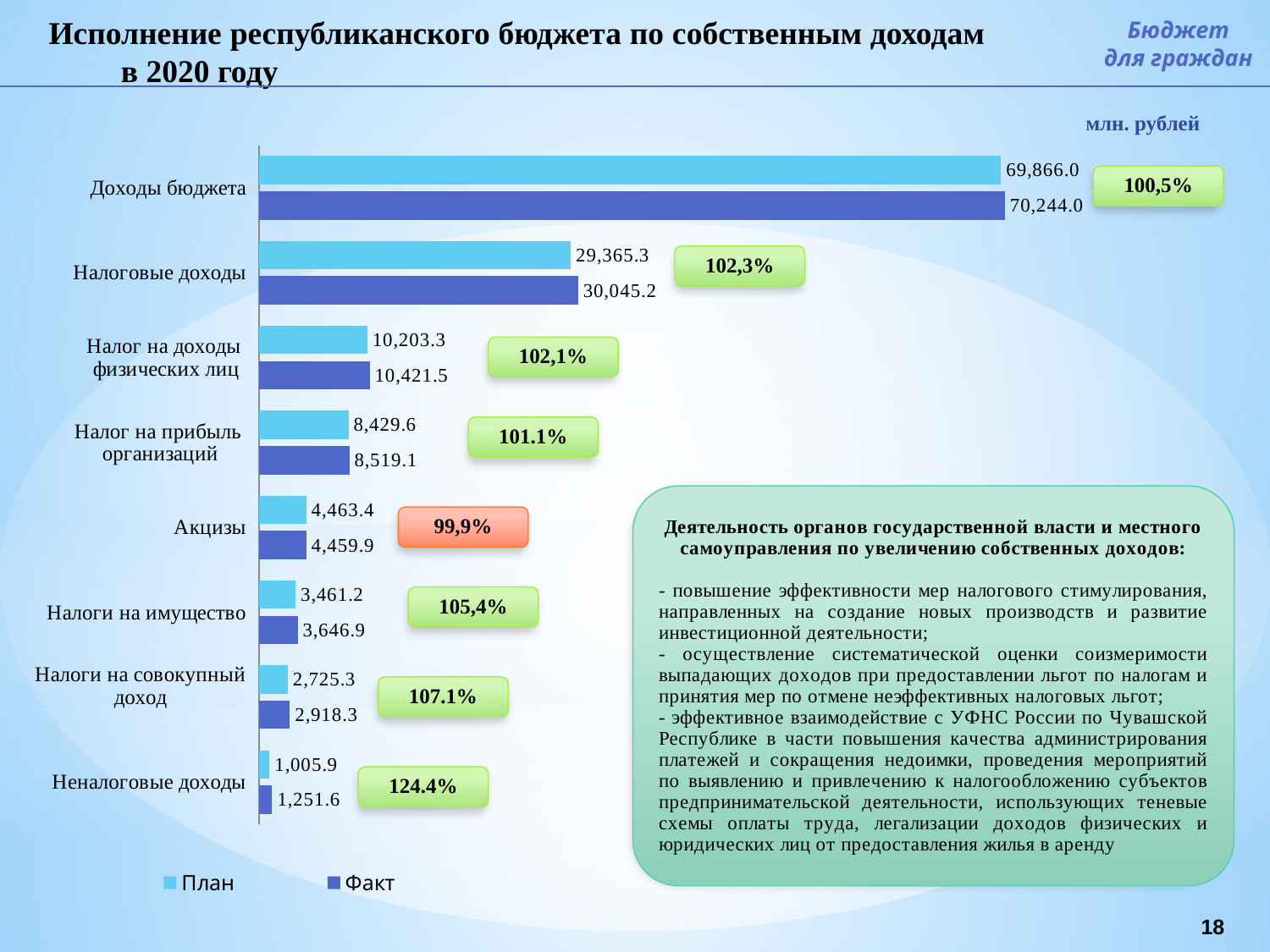
What is the Факт value for Неналоговые доходы? 1,251.6 How many series does the legend list? 2 What type of chart is shown on the slide? Bar chart For Налоги на имущество, which is larger: the План value or the Факт value? Факт What is the Факт (actual) value for Налоговые доходы? 30,045.2 How many categories are shown in the chart? 8 Which category has the lowest Факт value? Неналоговые доходы What percentage label is shown next to the Акцизы bars? 99,9% Which category has the highest План value? Доходы бюджета What is the difference between the Факт and План values for Доходы бюджета? 378.0 What is the План value for Акцизы? 4,463.4 What is the План (plan) value for Доходы бюджета? 69,866.0